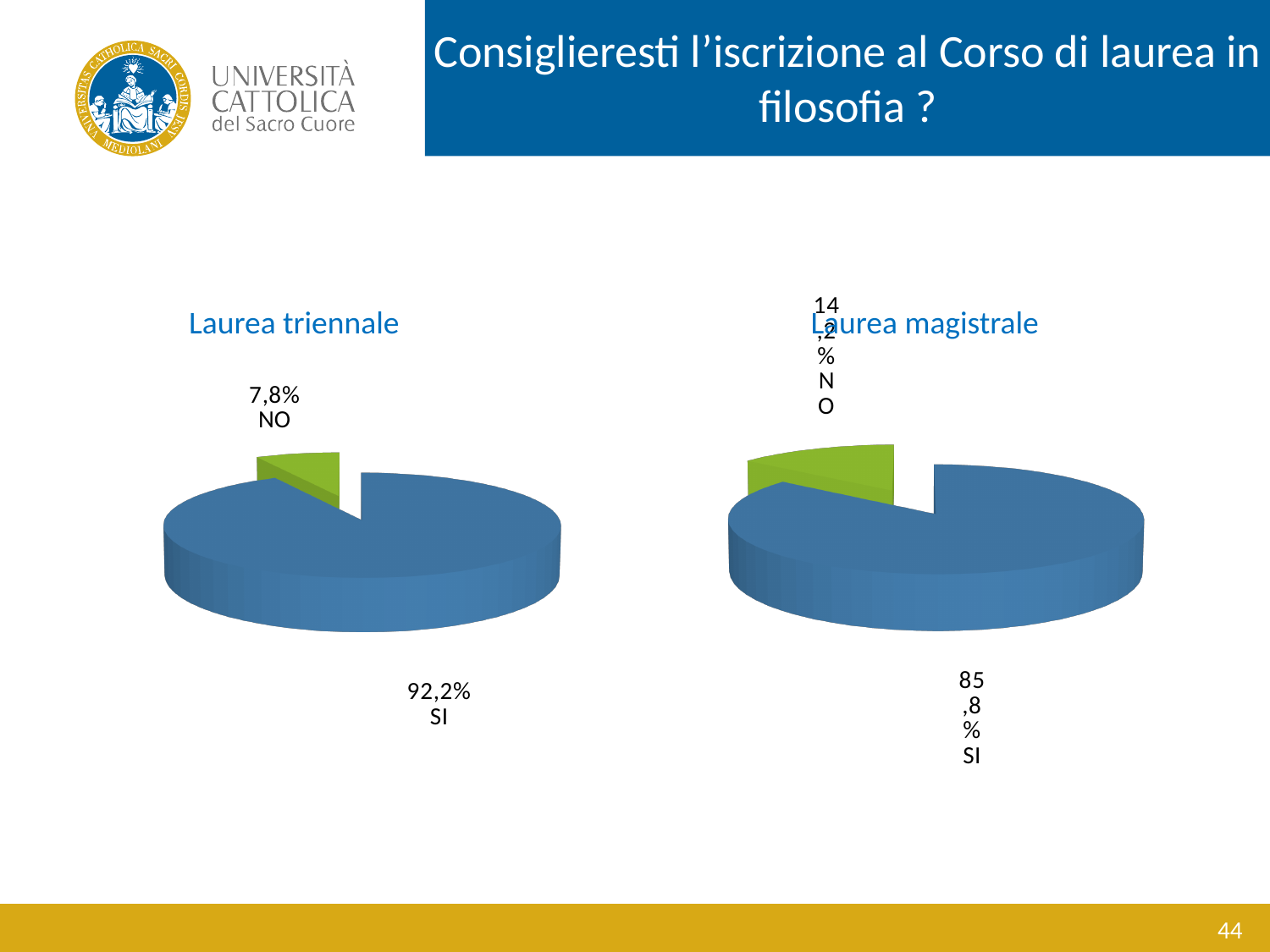
In the "Laurea magistrale" chart, what percentage answered SI? 85,8% In the "Laurea triennale" chart, what percentage answered SI? 92,2% In the "Laurea triennale" chart, which answer has the largest slice? SI In the "Laurea magistrale" chart, which answer has the smallest slice? NO In the "Laurea triennale" chart, what percentage answered NO? 7,8% In the "Laurea magistrale" chart, what percentage answered NO? 14,2% Which chart has the larger NO share, "Laurea triennale" or "Laurea magistrale"? Laurea magistrale In the "Laurea triennale" chart, what is the difference between the SI and NO percentages? 84,4% What colour is the NO slice in the "Laurea magistrale" chart? Green What is the difference between the SI percentage in the "Laurea triennale" chart and the SI percentage in the "Laurea magistrale" chart? 6,4% How many slices does the "Laurea magistrale" pie chart have? 2 What kind of chart is the "Laurea triennale" chart? Pie chart